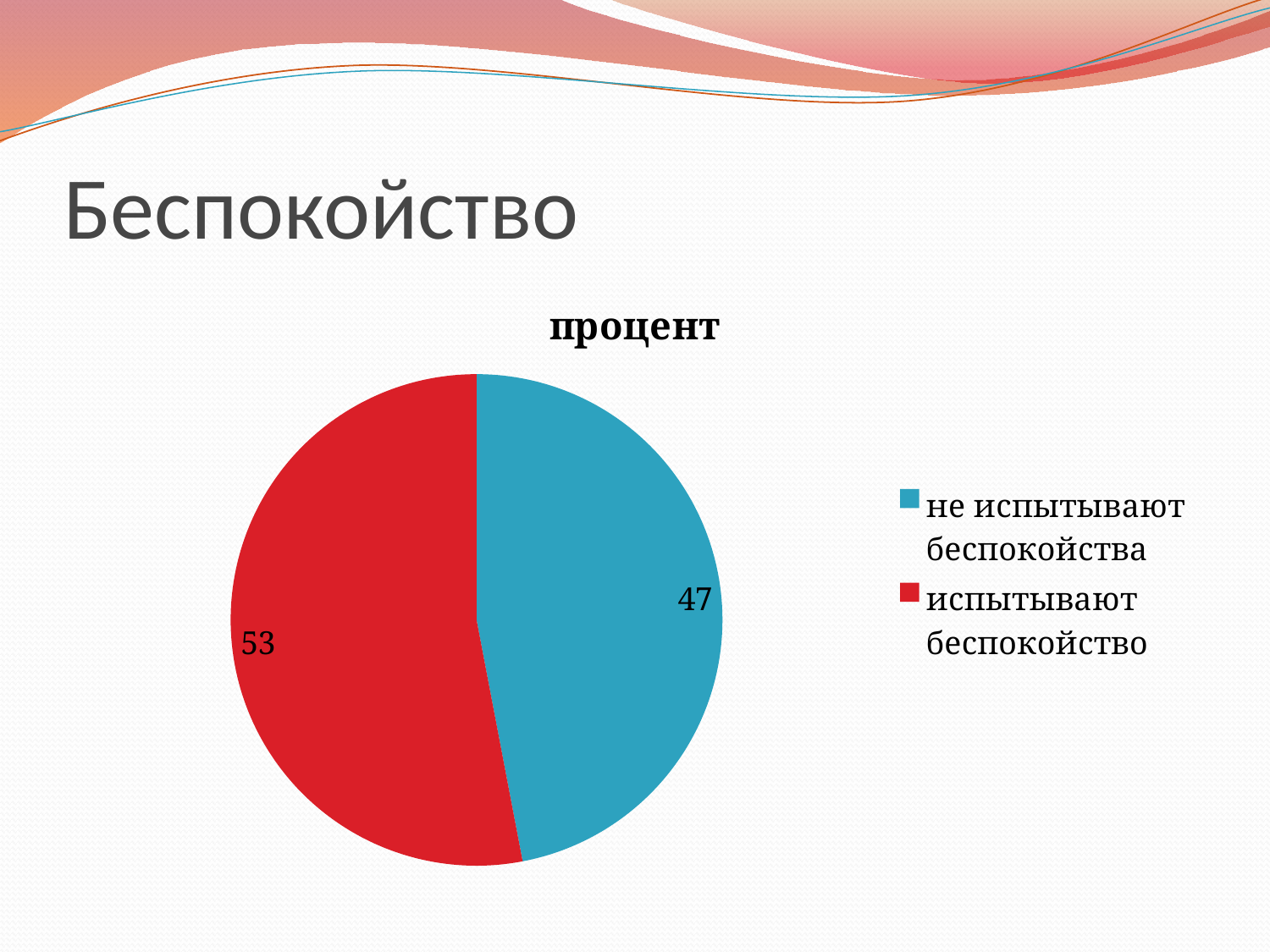
Which category has the largest slice of the pie? испытывают беспокойство How many slices does the pie chart have? 2 Which category has the smallest slice of the pie? не испытывают беспокойства What is the value for "не испытывают беспокойства"? 47 Which is larger: the value for "испытывают беспокойство" or for "не испытывают беспокойства"? испытывают беспокойство What is the value for "испытывают беспокойство"? 53 What is the title of the chart? процент How many entries does the legend list? 2 What is the difference between the values for "испытывают беспокойство" and "не испытывают беспокойства"? 6 What kind of chart is shown on the slide? pie chart What is the total of the two slice values? 100 What colour is the slice for "испытывают беспокойство"? red